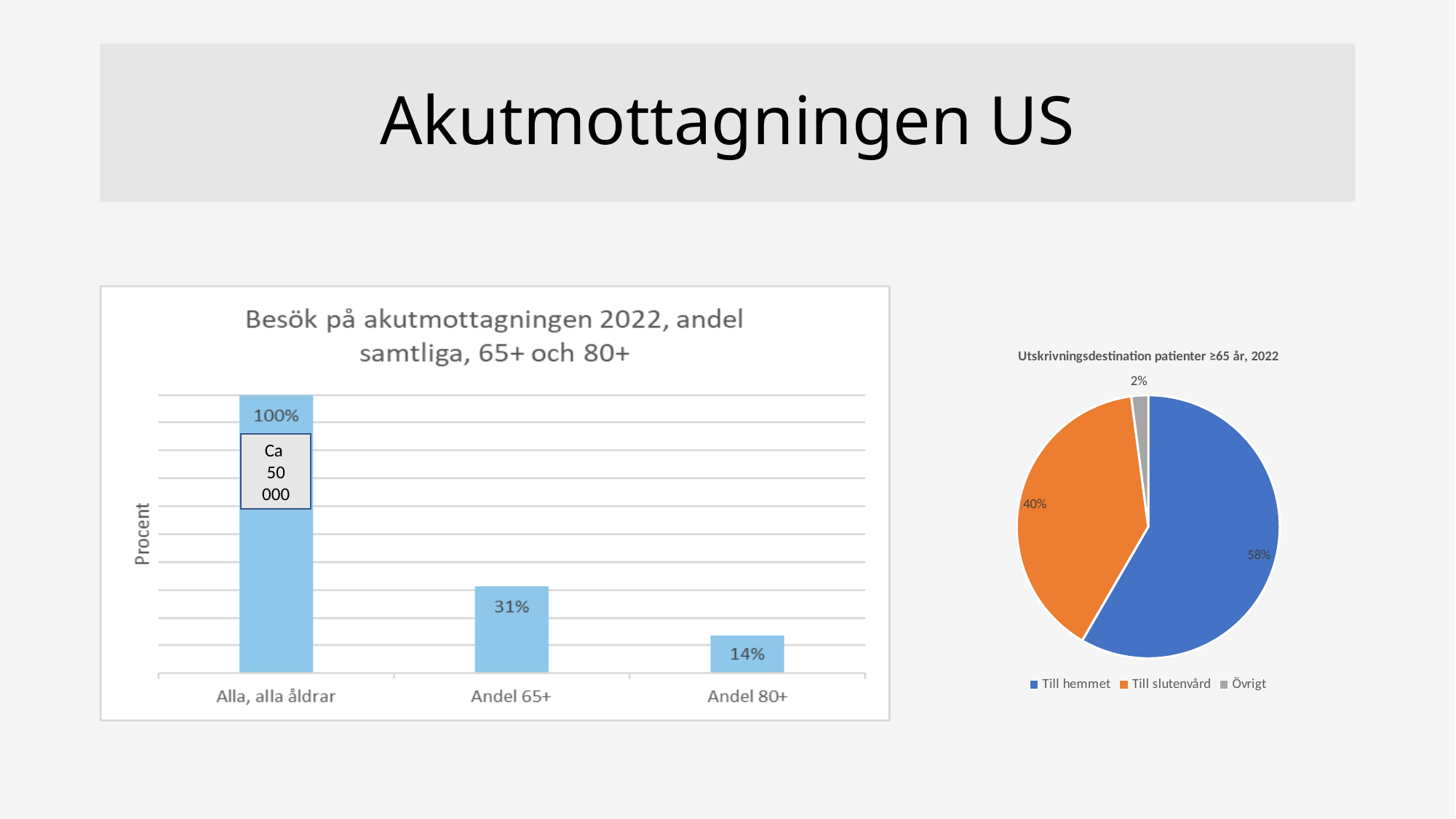
In the pie chart on the right, which category has the largest slice? Till hemmet In the bar chart on the left, what is the difference between the values for 'Andel 65+' and 'Andel 80+'? 17% In the bar chart on the left, do the values rise or fall from left to right along the x axis? Fall In the bar chart on the left, which category has the lowest value? Andel 80+ In the pie chart 'Utskrivningsdestination patienter ≥65 år, 2022', what share does 'Till slutenvård' have? 40% In the bar chart on the left, what is the label on the vertical axis? Procent In the pie chart on the right, what is the difference between the shares for 'Till hemmet' and 'Till slutenvård'? 18% In the bar chart on the left, what is the value for 'Andel 80+'? 14% In the bar chart on the left, how many categories are shown on the x axis? 3 In the bar chart 'Besök på akutmottagningen 2022, andel samtliga, 65+ och 80+', what is the value for 'Andel 65+'? 31% What kind of chart is the chart on the left of the slide? Bar chart How many entries does the legend of the pie chart on the right list? 3